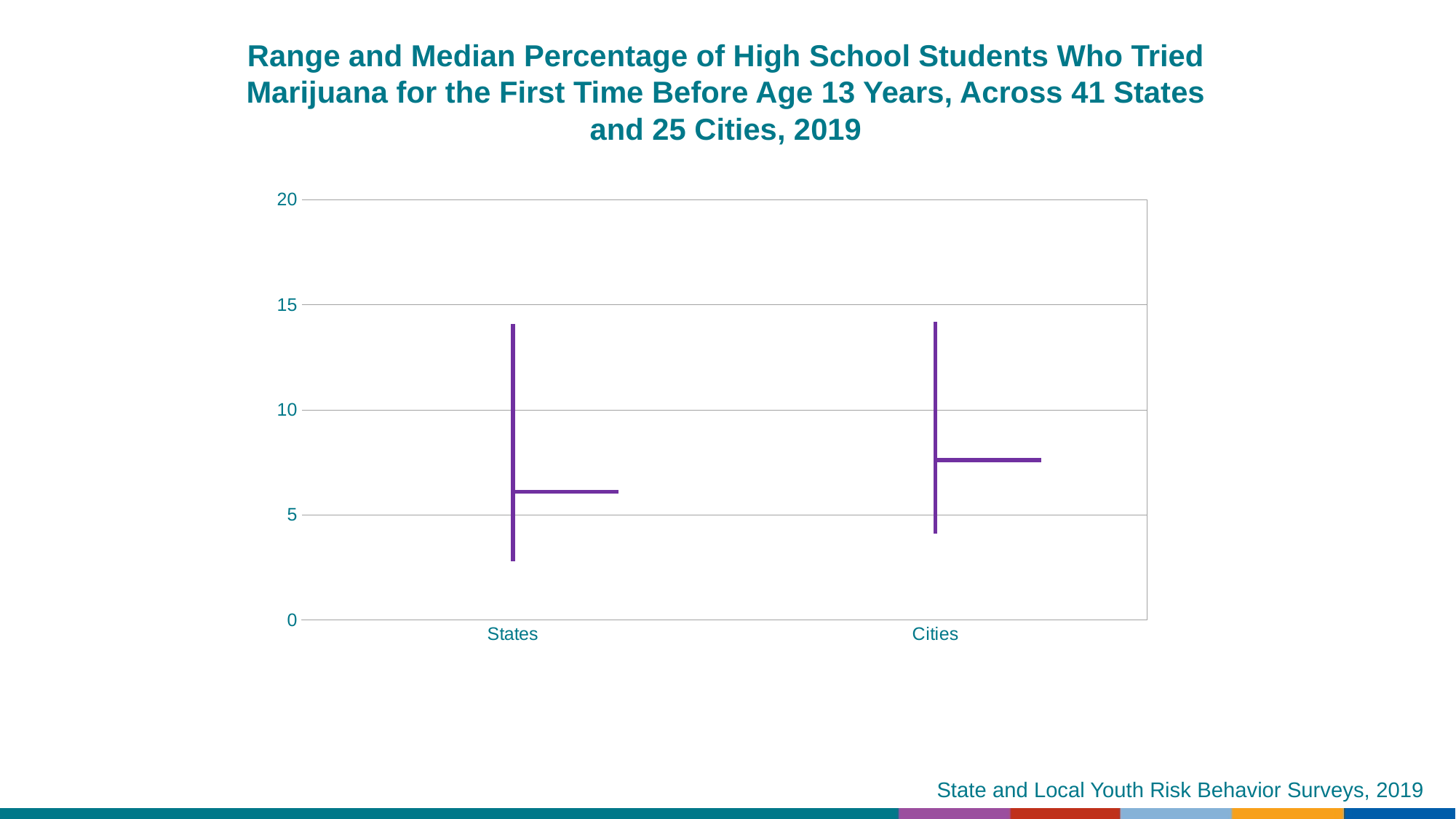
Which has the higher median, States or Cities? Cities Which category has the lower bottom of its range, States or Cities? States What is the data source cited at the bottom of the slide? State and Local Youth Risk Behavior Surveys, 2019 How many categories are shown on the x axis? 2 Is the median value for Cities greater or less than 5? greater Is the top of the range for Cities greater or less than 10? greater Is the median value for States greater or less than 5? greater How many states does the chart title say the data covers? 41